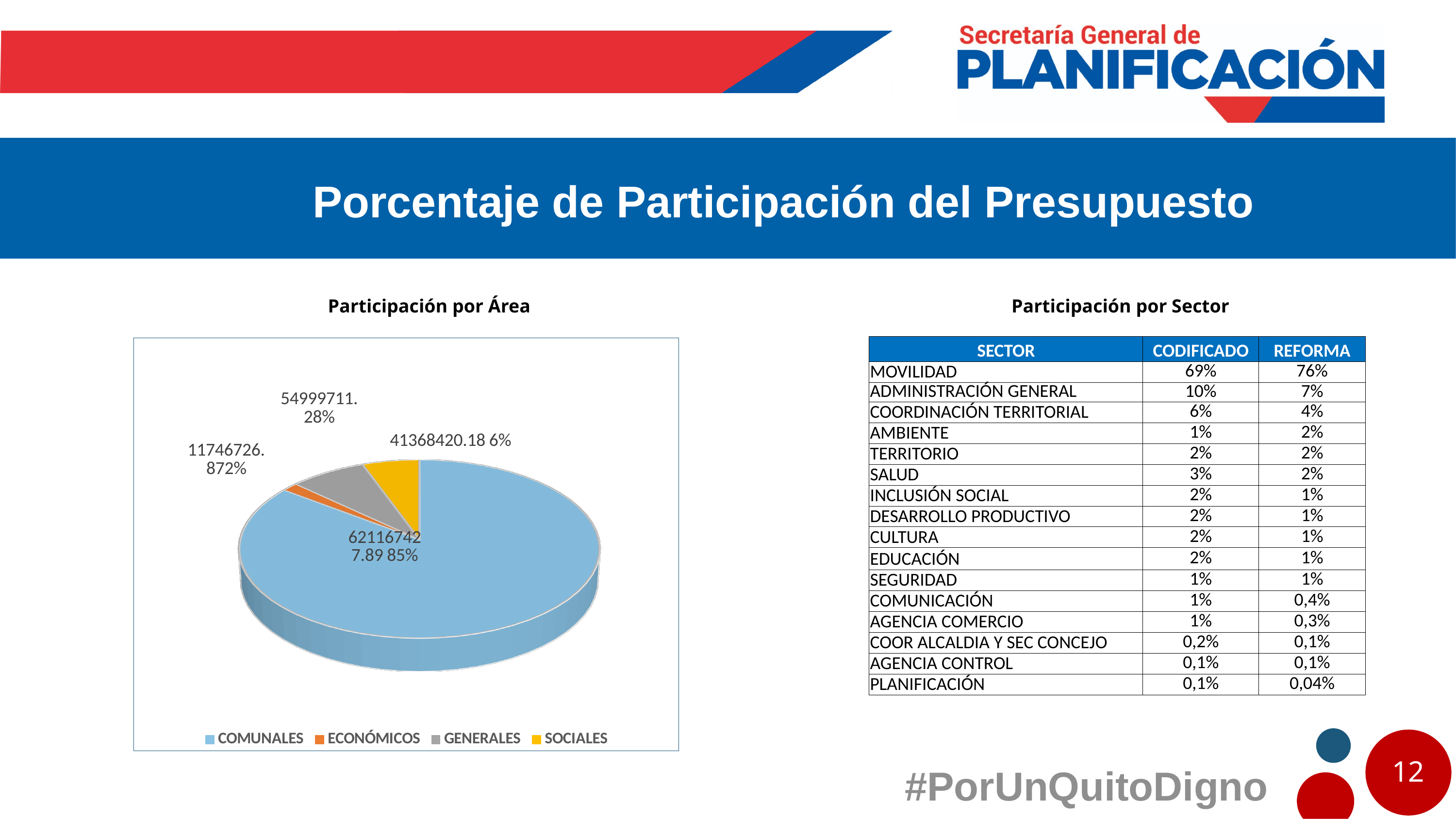
Which category has the smallest slice in the "Participación por Área" pie chart? ECONÓMICOS How many categories does the legend of the "Participación por Área" pie chart list? 4 Which category has the largest slice in the "Participación por Área" pie chart? COMUNALES Which category is shown in orange in the "Participación por Área" pie chart? ECONÓMICOS What share of the "Participación por Área" pie does SOCIALES represent? 6% In the "Participación por Área" pie chart, which slice is larger, COMUNALES or GENERALES? COMUNALES In the "Participación por Área" pie chart, which slice is larger, SOCIALES or ECONÓMICOS? SOCIALES What kind of chart is shown under the title "Participación por Área"? pie chart What share of the "Participación por Área" pie does COMUNALES represent? 85% What colour is the COMUNALES slice in the "Participación por Área" pie chart? blue